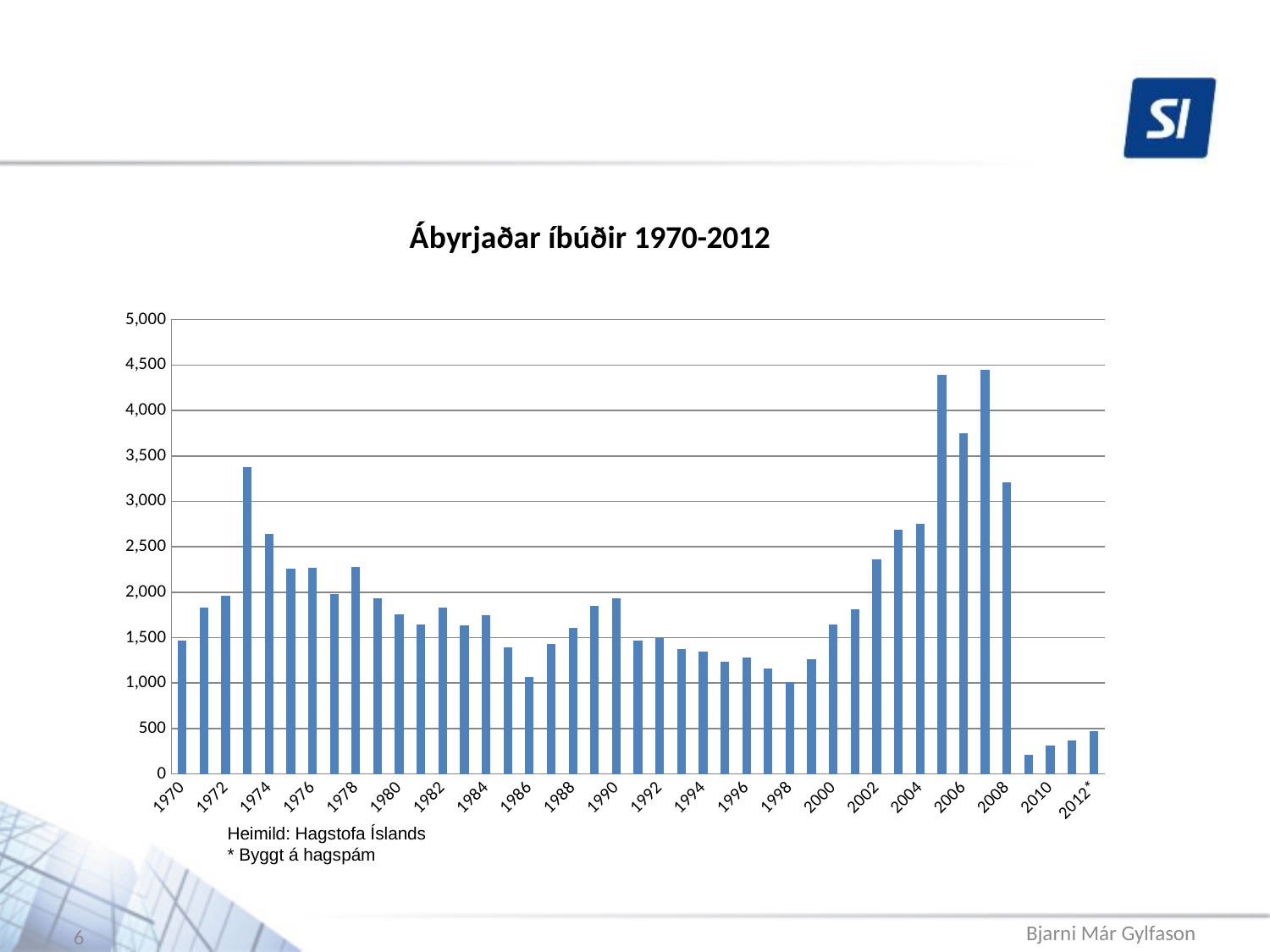
How many years (bars) are plotted in the chart? 43 Which is larger, the value for 2006 or the value for 2008? 2006 Which is larger, the value for 1973 or the value for 1974? 1973 Is the value for 1973 greater or less than 3,000? greater What kind of chart is shown on the slide? Bar chart Which year has the lowest value in the chart? 2009 Is the value for 2005 greater or less than 4,000? greater What is the title of the chart? Ábyrjaðar íbúðir 1970-2012 Is the value for 1986 greater or less than 1,500? less Do the values rise or fall from 2009 to 2012*? rise What source is cited below the chart? Hagstofa Íslands